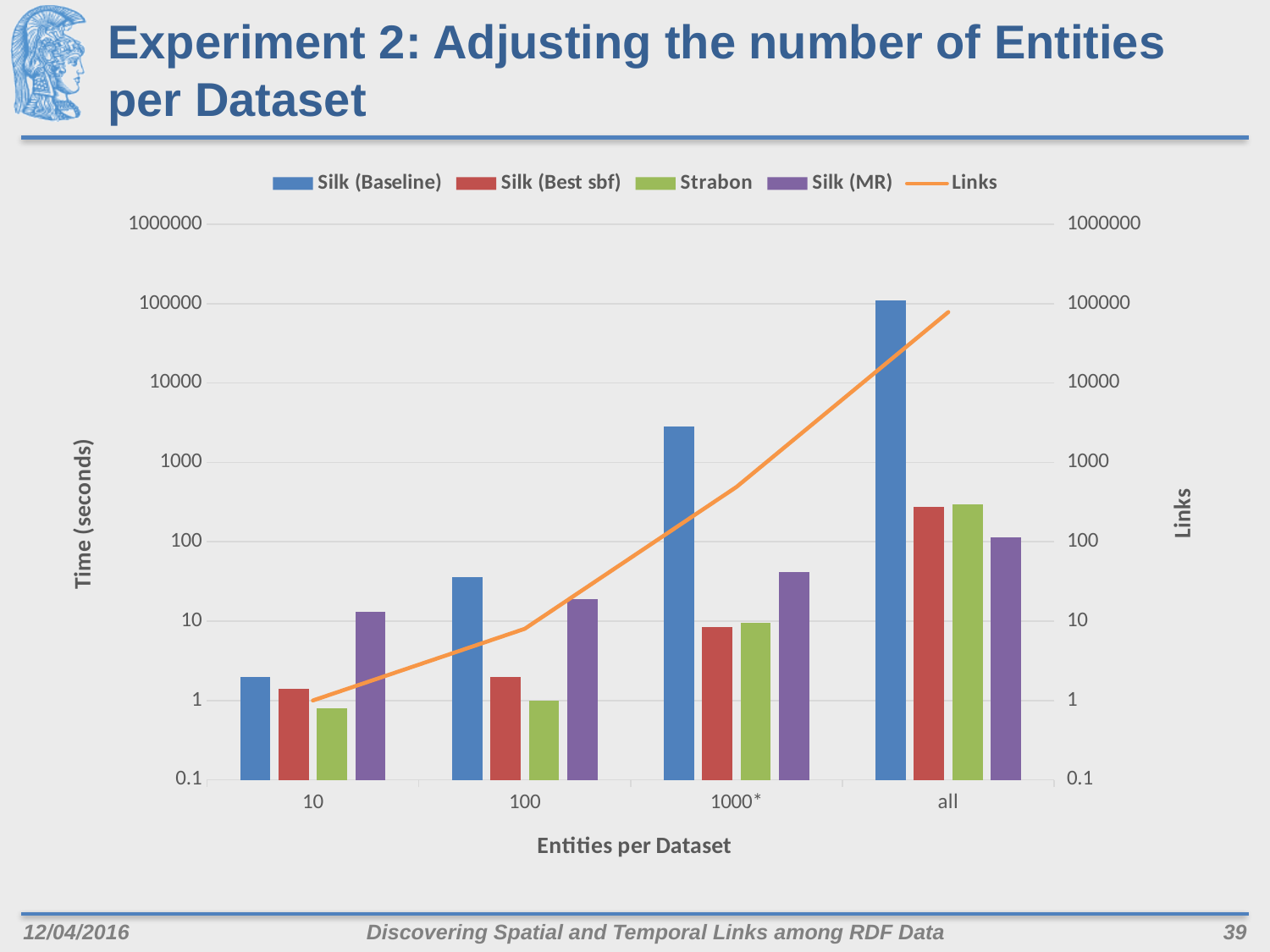
Which series is plotted as a line rather than bars? Links Is the value for Silk (Baseline) at '1000*' greater or less than 1000? greater Is the value for Silk (MR) at '100' greater or less than 10? greater How many categories are shown on the x axis (Entities per Dataset)? 4 Does the Links line rise or fall as the number of entities per dataset increases along the x axis? Rises What kind of chart is shown on the slide? Combined bar and line chart Is the value for Strabon at '10' greater or less than 1? less What is the title of the left vertical axis? Time (seconds) At 'all', which is larger: Silk (Baseline) or Silk (MR)? Silk (Baseline) How many series does the legend list? 5